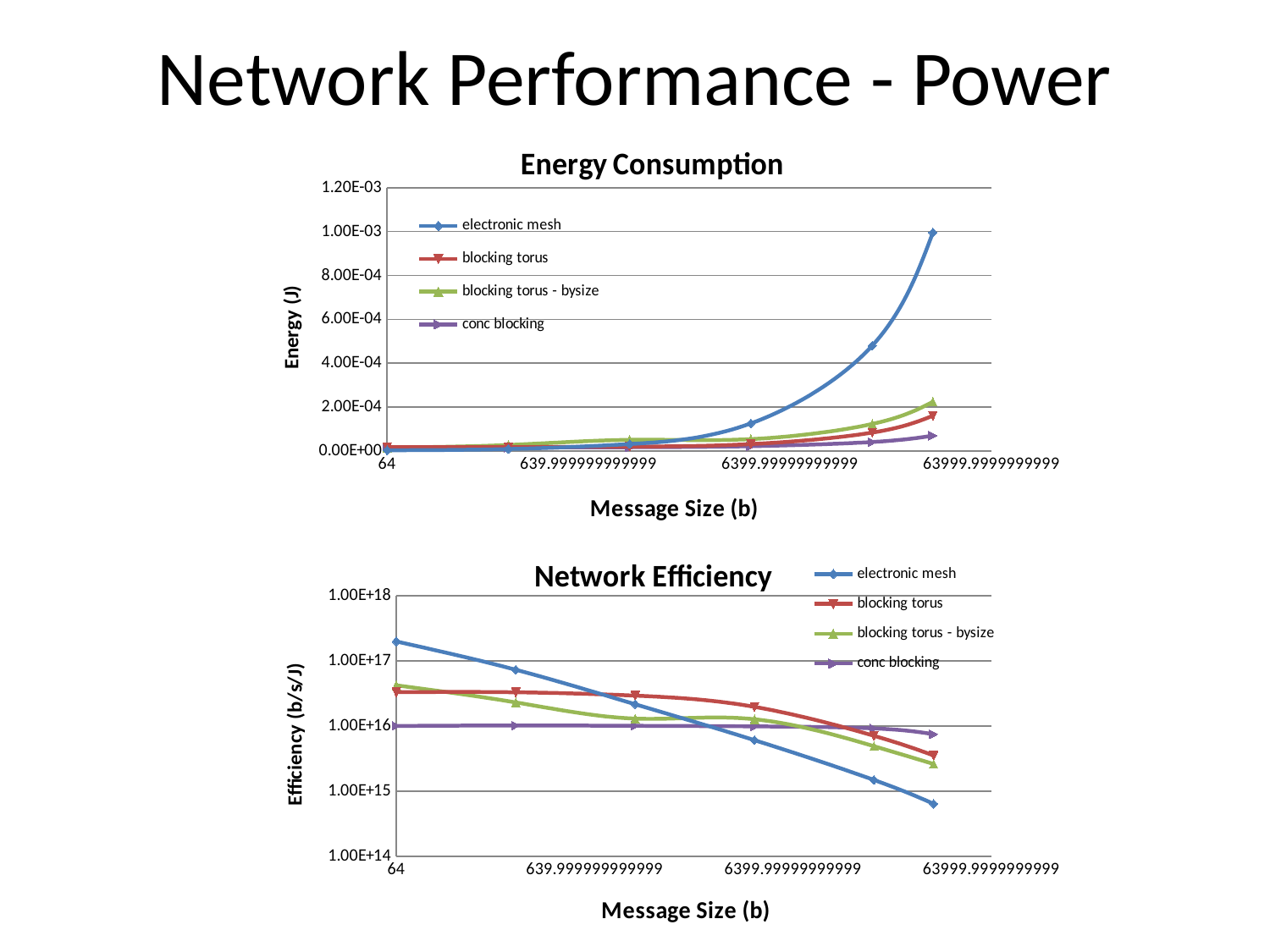
In the Network Efficiency chart, does the electronic mesh series rise or fall as message size increases? fall What kind of chart is the Energy Consumption chart? line chart In the Network Efficiency chart, is the value for electronic mesh at the largest message size greater or less than 1.00E+15? less In the Energy Consumption chart, is the value for electronic mesh at the largest message size greater or less than 8.00E-04? greater In the Energy Consumption chart, which series has the lowest energy at the largest message size? conc blocking In the Network Efficiency chart, which series has the highest efficiency at message size 64? electronic mesh In the Energy Consumption chart, which series has the highest energy at the largest message size? electronic mesh In the Network Efficiency chart, which series has the lowest efficiency at the largest message size? electronic mesh How many series does the legend of the Network Efficiency chart list? 4 In the Energy Consumption chart, does the electronic mesh series rise or fall as message size increases? rise In the Network Efficiency chart, is the value for electronic mesh at message size 64 greater or less than 1.00E+17? greater What is the y-axis label of the Network Efficiency chart? Efficiency (b/s/J)